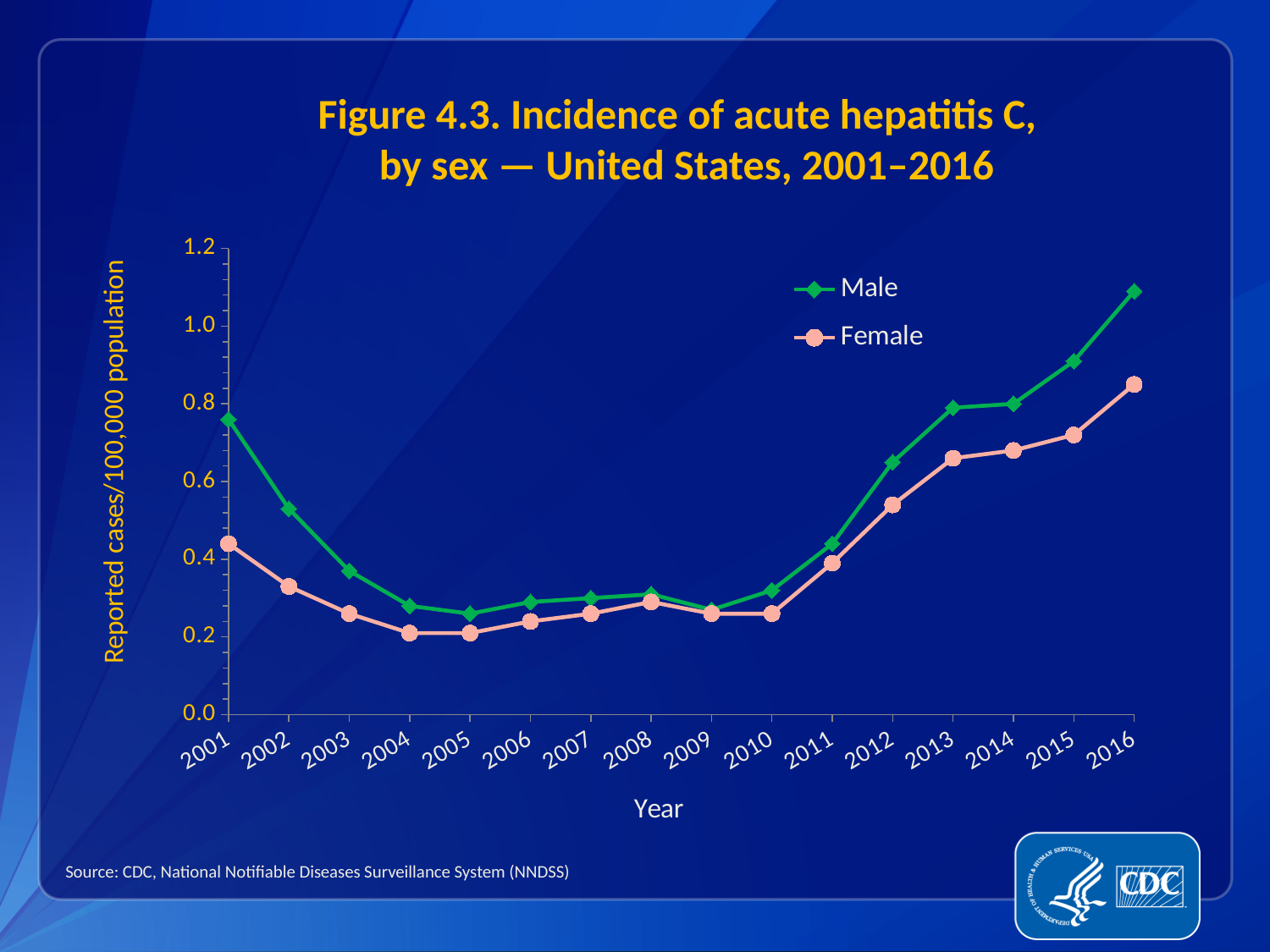
Is the Male value for 2001 greater or less than 0.6? greater Is the Female value for 2016 greater or less than 0.8? greater Is the Male value for 2016 greater or less than 1.0? greater What kind of chart is shown on the slide? line chart In which year is the Male incidence rate highest? 2016 Which series has the higher value in 2016, Male or Female? Male In which year is the Female incidence rate highest? 2016 Does the Male incidence rate rise or fall from 2001 to 2004? fall What is the label of the y axis? Reported cases/100,000 population How many years are plotted along the x axis? 16 How many series does the legend list? 2